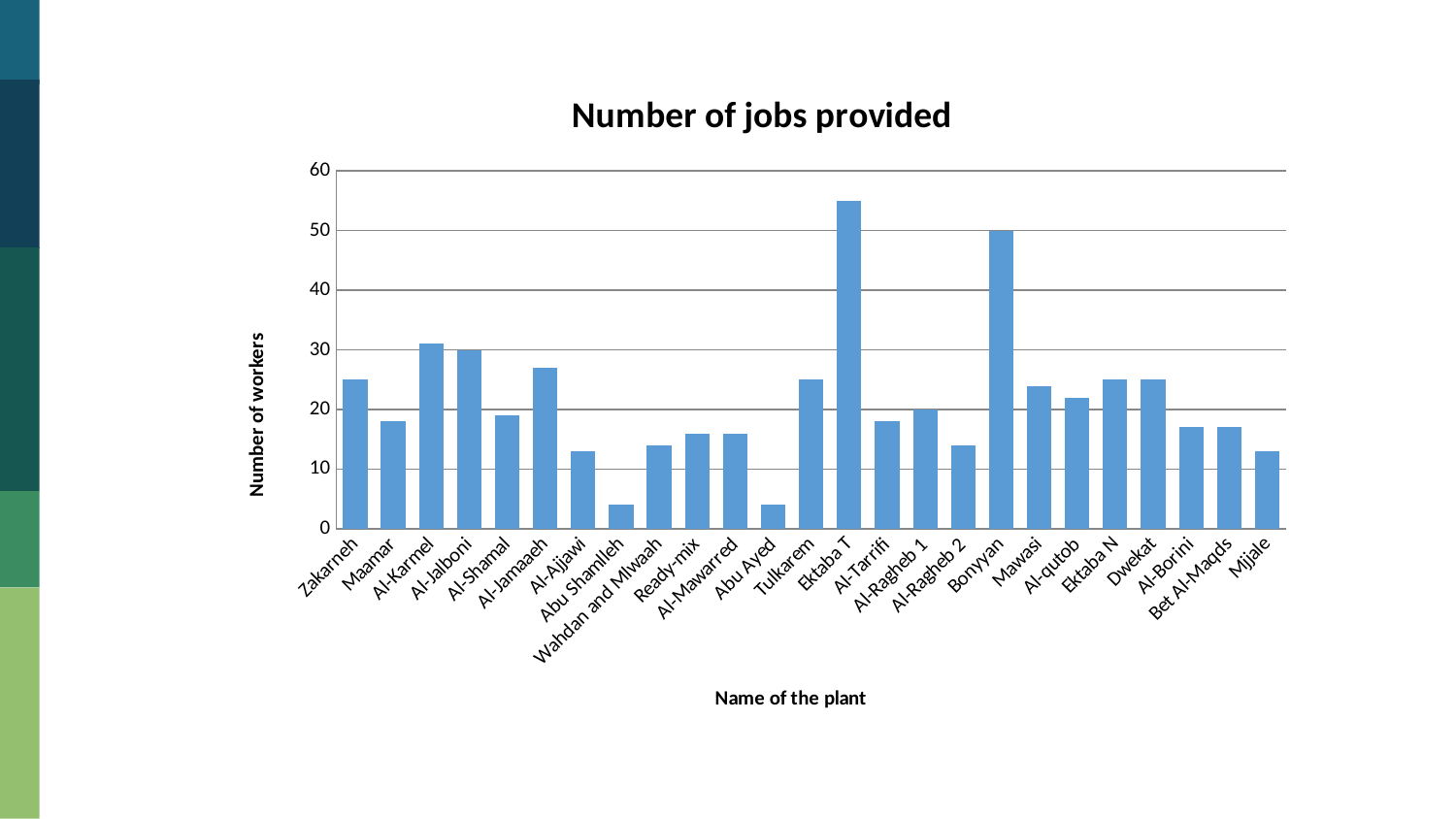
Is the value for Al-Jamaaeh greater or less than 30? less Which plant provides the highest number of jobs? Ektaba T What kind of chart is shown on the slide? bar chart Which has more workers, Al-Karmel or Maamar? Al-Karmel How many plants are shown on the x axis? 25 Is the value for Ektaba T greater or less than 50? greater Is the value for Abu Shamlleh greater or less than 10? less Which has more workers, Ektaba T or Bonyyan? Ektaba T What is the title of the chart? Number of jobs provided What is the label of the vertical axis? Number of workers